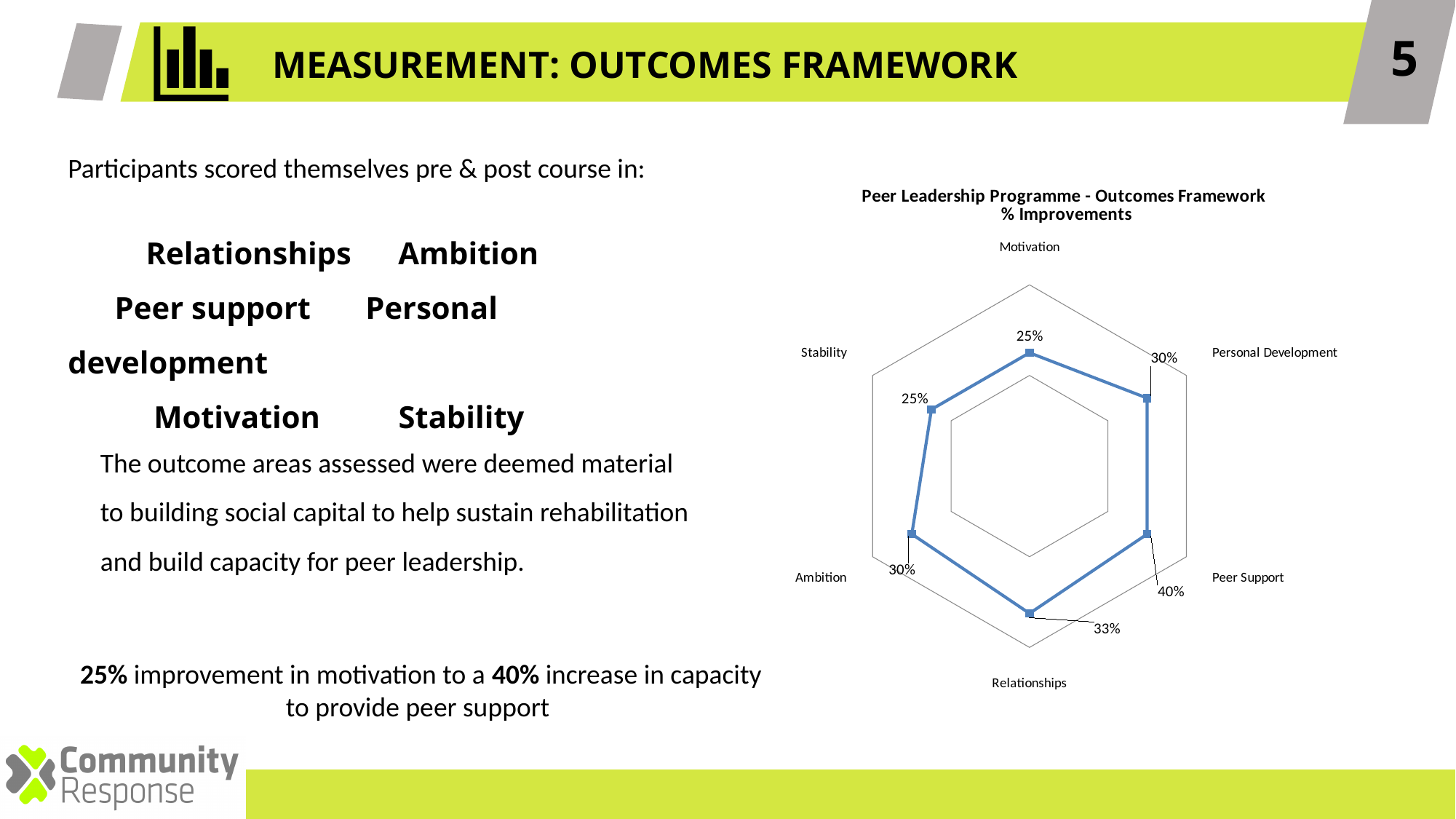
What is the % improvement for Relationships? 33% What is the % improvement for Personal Development? 30% How many outcome areas are plotted on the chart? 6 What is the % improvement for Stability? 25% What is the % improvement for Motivation? 25% Which has a larger % improvement, Relationships or Ambition? Relationships What type of chart is shown on the slide? radar chart What is the title of the chart? Peer Leadership Programme - Outcomes Framework % Improvements What is the difference between the % improvement for Relationships and for Stability? 8% What is the difference between the % improvement for Peer Support and for Motivation? 15% What is the % improvement for Peer Support? 40% Which outcome area has the highest % improvement? Peer Support